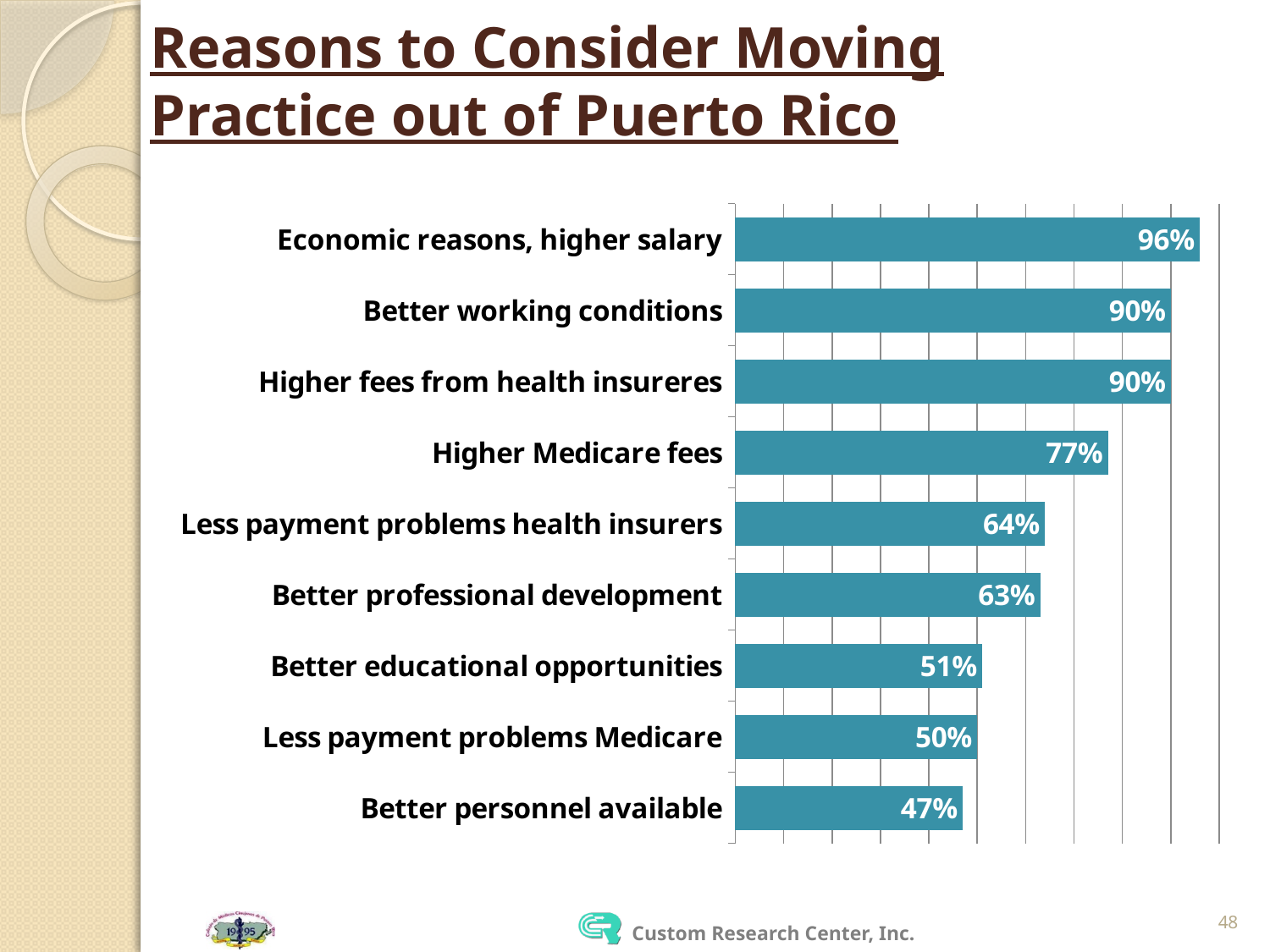
Which is larger, Less payment problems health insurers or Better educational opportunities? Less payment problems health insurers What is the value for Higher Medicare fees? 77% Which category has the highest value? Economic reasons, higher salary What is the difference between Economic reasons, higher salary and Better working conditions? 6% Which category has the lowest value? Better personnel available What is the value for Better personnel available? 47% What kind of chart is shown on the slide? Bar chart What is the title of the slide? Reasons to Consider Moving Practice out of Puerto Rico How many categories are shown in the chart? 9 What is the difference between Higher Medicare fees and Less payment problems Medicare? 27% What is the value for Economic reasons, higher salary? 96% What is the value for Better educational opportunities? 51%